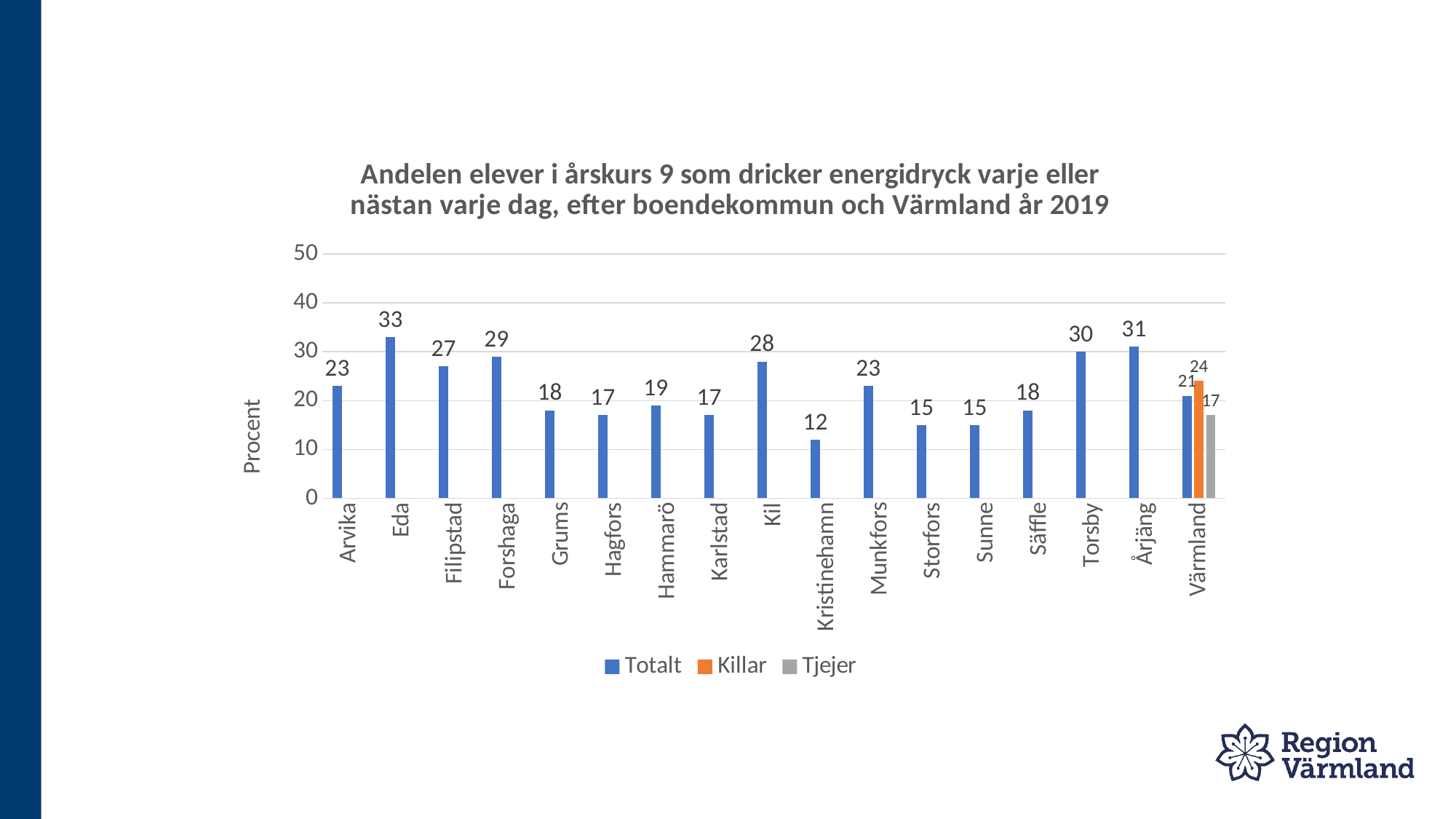
Which has a higher Totalt value, Torsby or Årjäng? Årjäng What is the difference between the Totalt values for Eda and Kristinehamn? 21 What is the Totalt value for Eda? 33 How many series does the legend list? 3 What is the Killar value for Värmland? 24 How many categories are shown on the x axis? 17 Is the Totalt value for Kil greater or less than 20? greater Which category has the lowest Totalt value? Kristinehamn Which category has the highest Totalt value? Eda What is the label of the y axis? Procent What kind of chart is shown on the slide? bar chart What is the Tjejer value for Värmland? 17